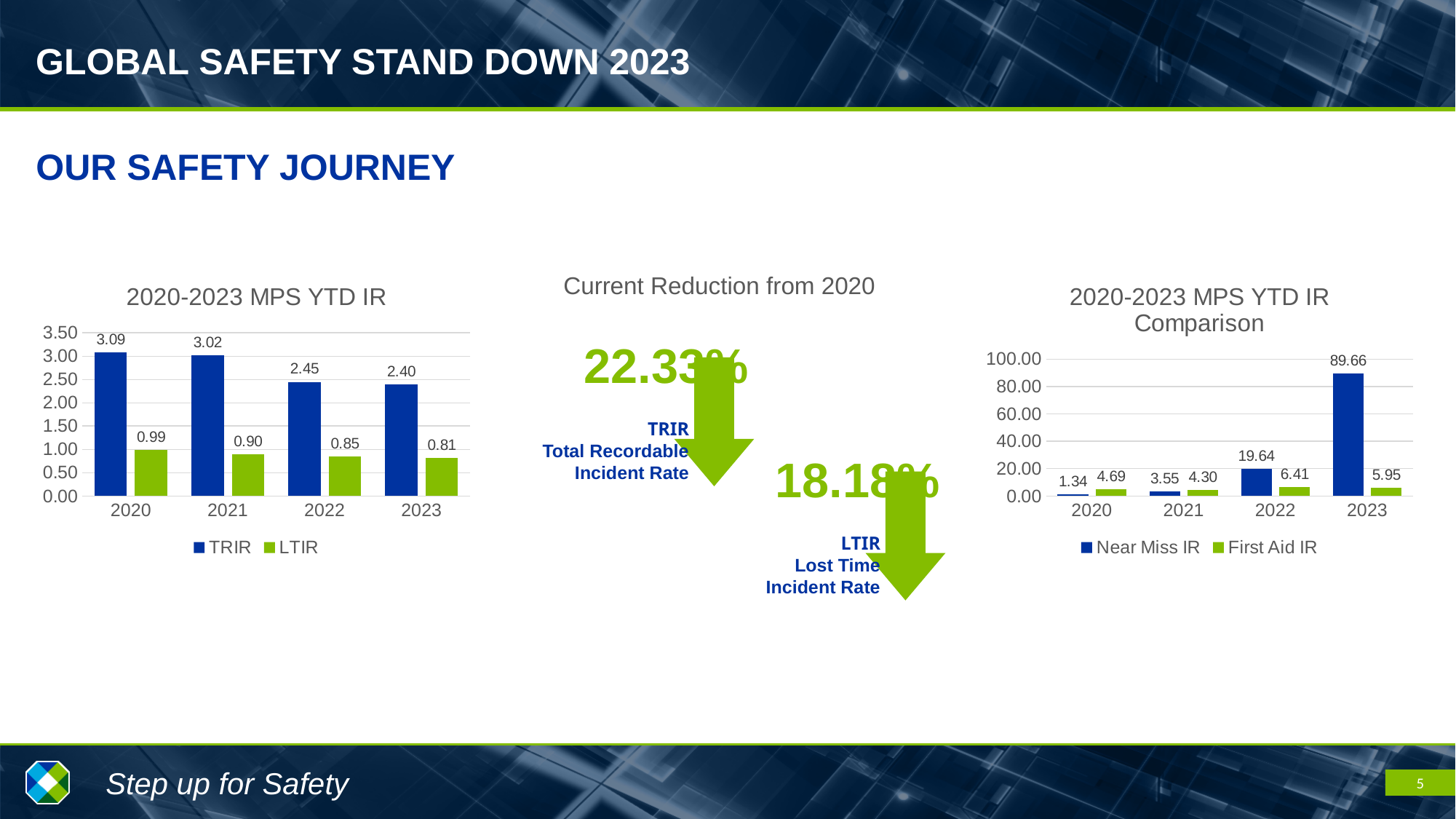
In the '2020-2023 MPS YTD IR' chart, what is the difference between the TRIR values for 2020 and 2023? 0.69 In the '2020-2023 MPS YTD IR Comparison' chart, which is larger for 2021: Near Miss IR or First Aid IR? First Aid IR In the '2020-2023 MPS YTD IR' chart, what is the TRIR value for 2020? 3.09 In the '2020-2023 MPS YTD IR Comparison' chart, what is the difference between the Near Miss IR values for 2023 and 2022? 70.02 In the '2020-2023 MPS YTD IR' chart, which year has the highest TRIR? 2020 In the '2020-2023 MPS YTD IR' chart, does TRIR rise or fall from 2020 to 2023? fall In the '2020-2023 MPS YTD IR' chart, what is the LTIR value for 2023? 0.81 In the '2020-2023 MPS YTD IR' chart, how many series does the legend list? 2 What type of chart is the '2020-2023 MPS YTD IR Comparison' chart? bar chart In the '2020-2023 MPS YTD IR' chart, which year has the lowest LTIR? 2023 In the '2020-2023 MPS YTD IR Comparison' chart, what is the First Aid IR value for 2022? 6.41 In the '2020-2023 MPS YTD IR Comparison' chart, what is the Near Miss IR value for 2023? 89.66